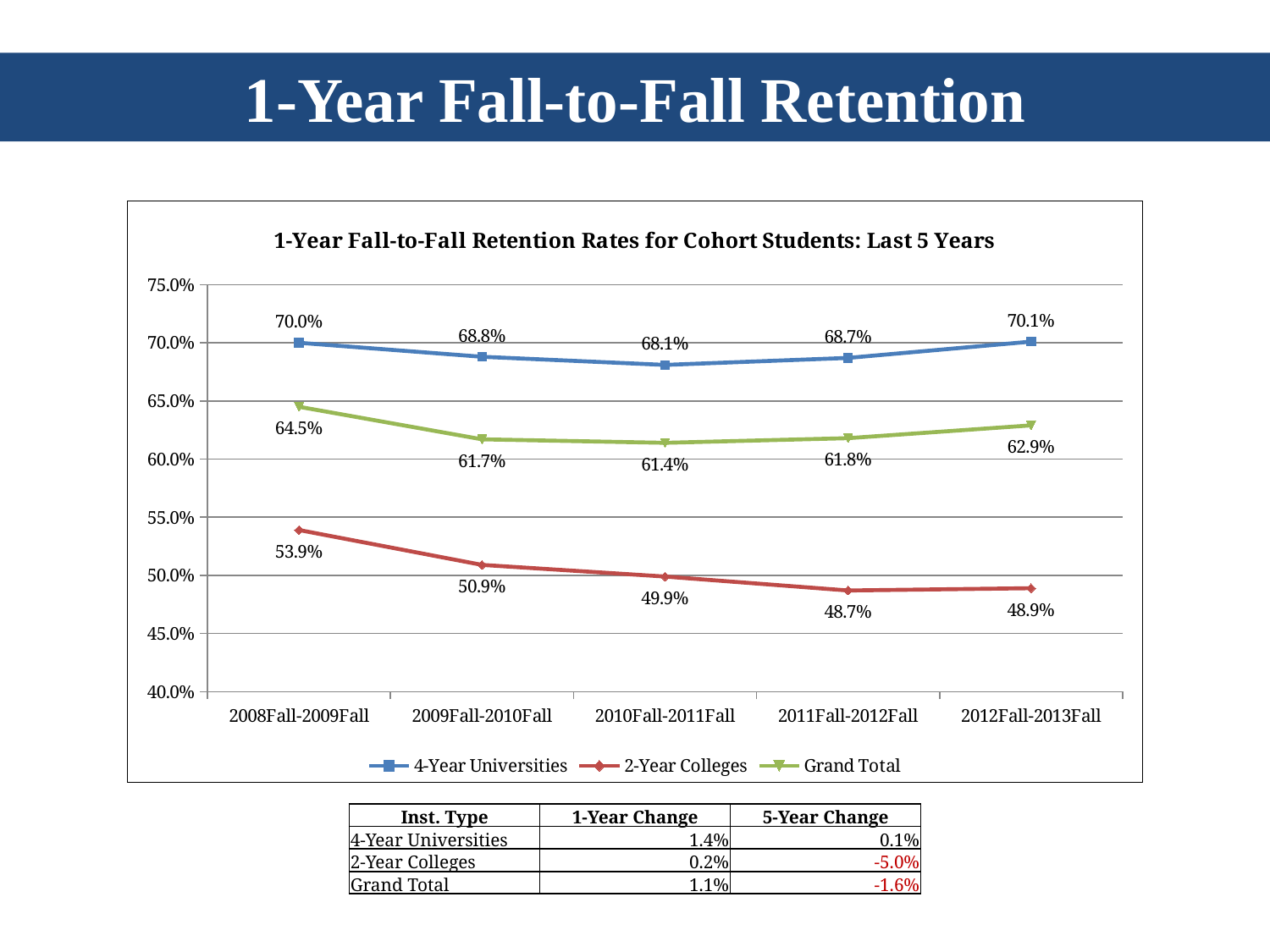
In which period is the 4-Year Universities retention rate highest? 2012Fall-2013Fall Does the 2-Year Colleges retention rate rise or fall from 2008Fall-2009Fall to 2011Fall-2012Fall? fall Which is higher in 2009Fall-2010Fall: the Grand Total rate or the 2-Year Colleges rate? Grand Total What kind of chart is shown? line chart What is the retention rate for 4-Year Universities in 2008Fall-2009Fall? 70.0% Is the 2-Year Colleges retention rate in 2008Fall-2009Fall greater or less than 50.0%? greater What is the retention rate for 2-Year Colleges in 2011Fall-2012Fall? 48.7% How many series does the legend list? 3 In which period is the 2-Year Colleges retention rate lowest? 2011Fall-2012Fall What is the Grand Total retention rate in 2012Fall-2013Fall? 62.9% How many periods are shown on the x axis? 5 What is the difference between the 4-Year Universities and 2-Year Colleges retention rates in 2010Fall-2011Fall? 18.2%